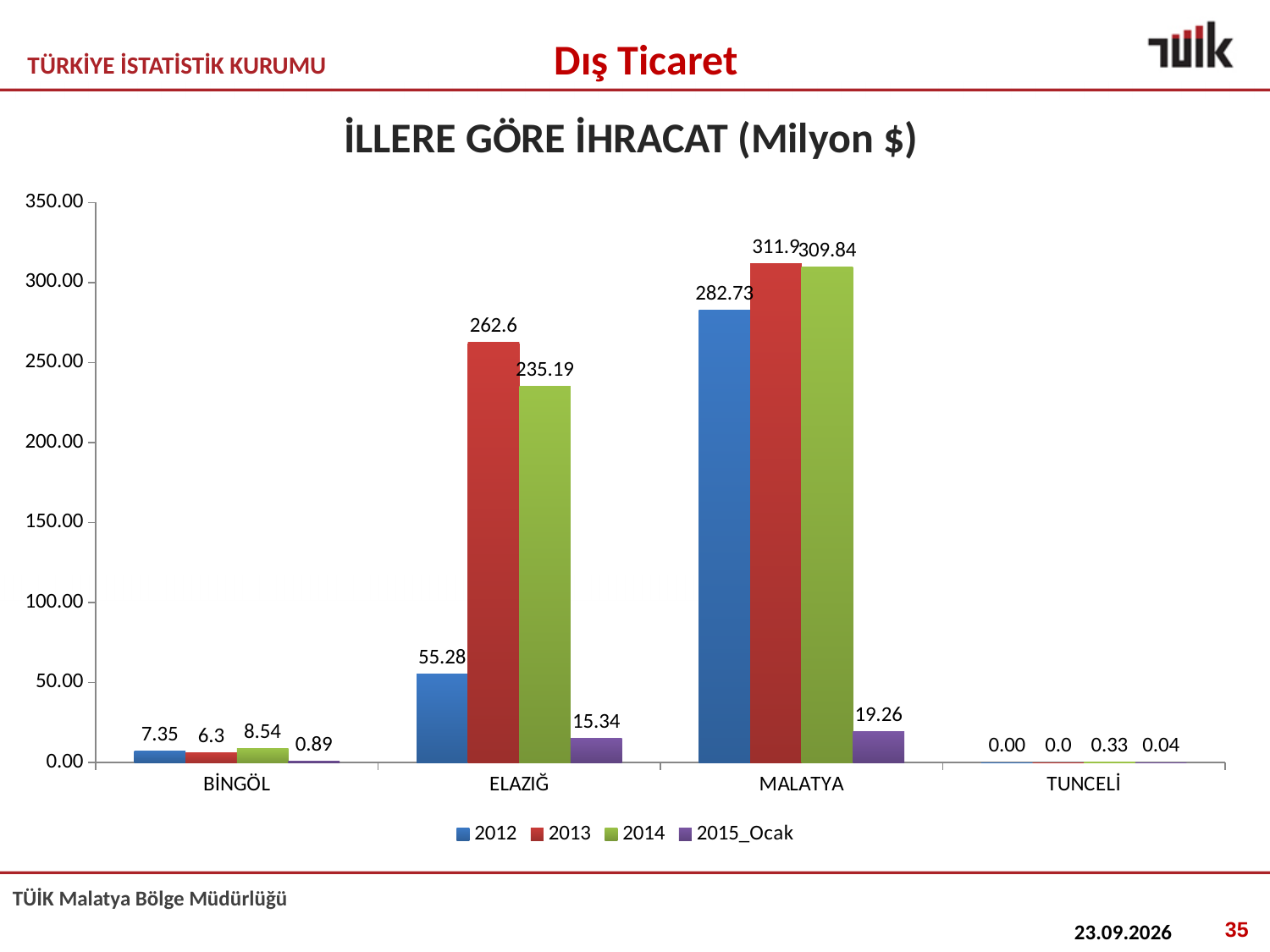
What type of chart is shown on the slide? Bar chart Which province has the lowest 2012 export value? TUNCELİ What is the title of the chart? İLLERE GÖRE İHRACAT (Milyon $) How many series does the legend list? 4 What is the 2012 export value for MALATYA? 282.73 What is the 2013 export value for ELAZIĞ? 262.6 What is the 2015_Ocak value for BİNGÖL? 0.89 Which is larger for BİNGÖL: the 2012 value or the 2014 value? 2014 What is the 2014 value for TUNCELİ? 0.33 Which province has the highest 2014 export value? MALATYA How many provinces are shown on the x axis? 4 What is the difference between the 2013 and 2014 values for ELAZIĞ? 27.41